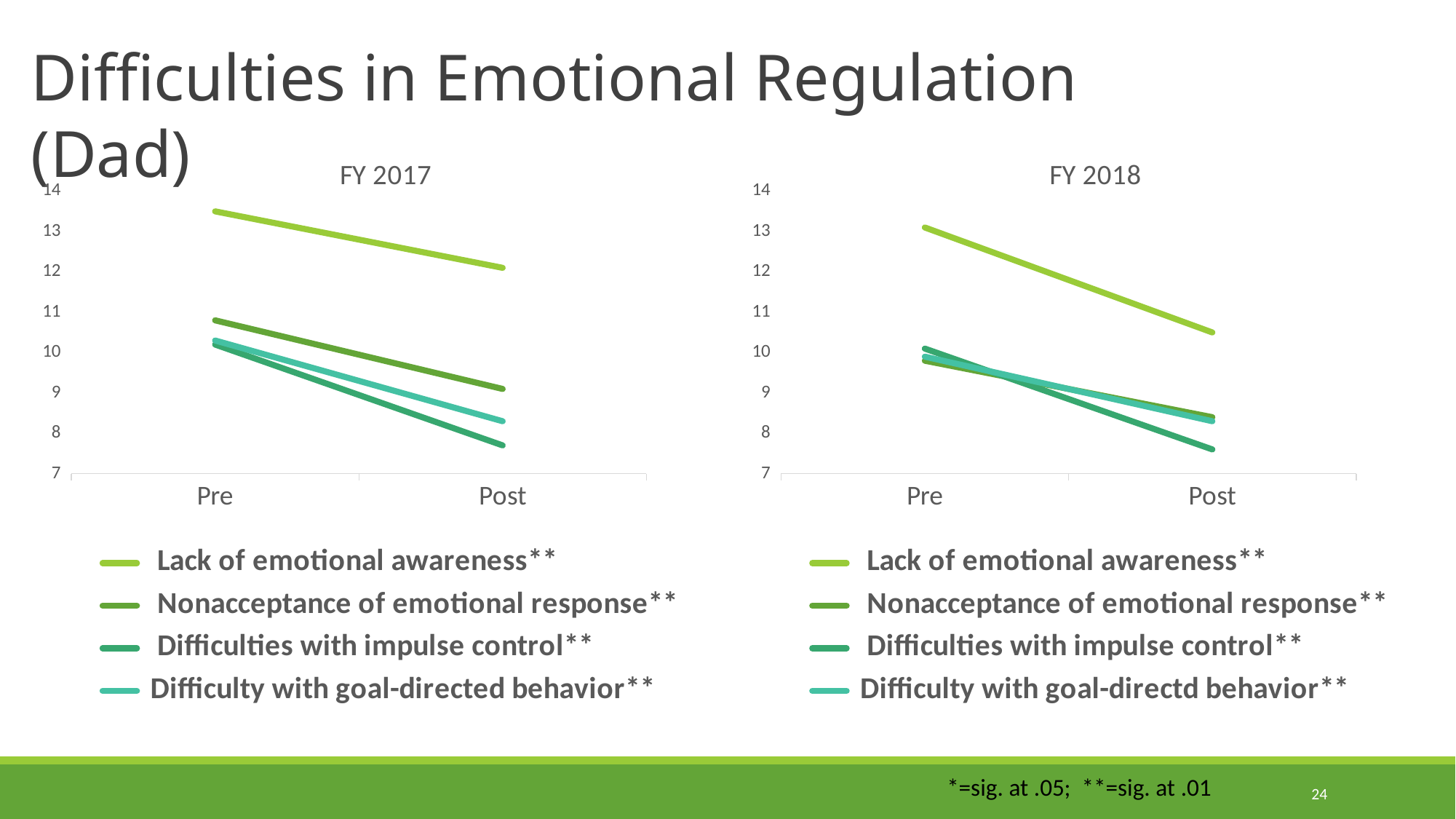
In the FY 2017 chart, which series has the lowest value at Post? Difficulties with impulse control How many series does the legend of the FY 2018 chart list? 4 In the FY 2017 chart, is the Pre value for Lack of emotional awareness greater or less than 13? greater In the FY 2017 chart, which series has the highest value at Pre? Lack of emotional awareness In the FY 2018 chart, is the Post value for Difficulties with impulse control greater or less than 8? less In the FY 2017 chart, does the Lack of emotional awareness line rise or fall from Pre to Post? fall What are the x-axis categories of the FY 2018 chart? Pre and Post In the FY 2018 chart, which is larger at Post: Lack of emotional awareness or Nonacceptance of emotional response? Lack of emotional awareness What kind of chart is the FY 2017 chart? line chart In the FY 2018 chart, which series has the highest value at Post? Lack of emotional awareness In the FY 2018 chart, does the Difficulties with impulse control line rise or fall from Pre to Post? fall How many categories are on the x axis of the FY 2017 chart? 2